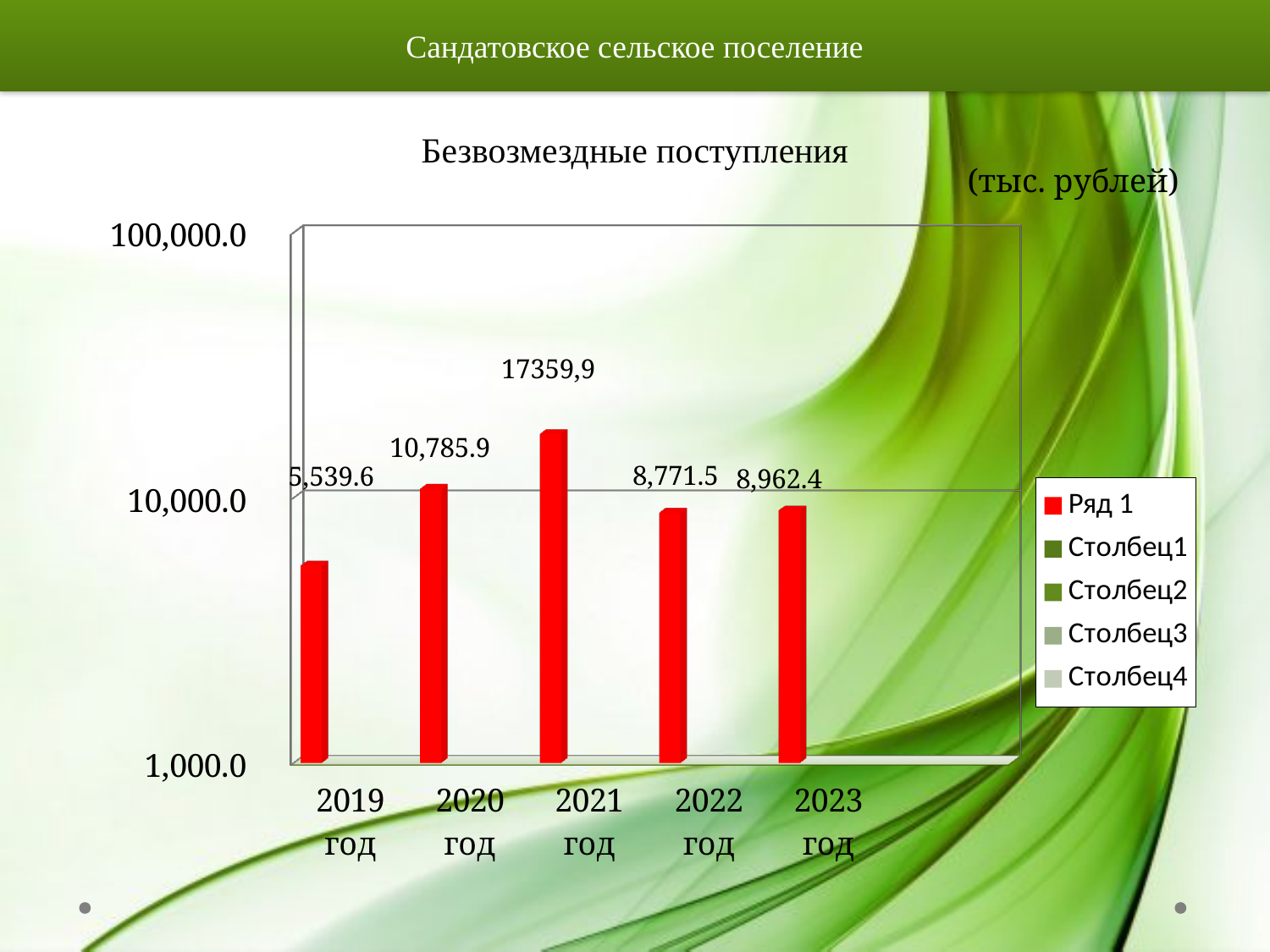
What is the value for 2023 год in the Безвозмездные поступления chart? 8,962.4 Is the value for 2019 год in the Безвозмездные поступления chart greater or less than 10,000.0? less What is the difference between the values for 2023 год and 2022 год in the Безвозмездные поступления chart? 190.9 What is the difference between the values for 2020 год and 2019 год in the Безвозмездные поступления chart? 5,246.3 How many entries does the legend of the Безвозмездные поступления chart list? 5 What is the value for 2019 год in the Безвозмездные поступления chart? 5,539.6 How many years are shown on the x axis of the Безвозмездные поступления chart? 5 Which is larger in the Безвозмездные поступления chart, the value for 2022 год or 2023 год? 2023 год What is the value for 2021 год in the Безвозмездные поступления chart? 17359,9 What kind of chart is the Безвозмездные поступления chart? bar chart Which year has the lowest value in the Безвозмездные поступления chart? 2019 год Which year has the highest value in the Безвозмездные поступления chart? 2021 год